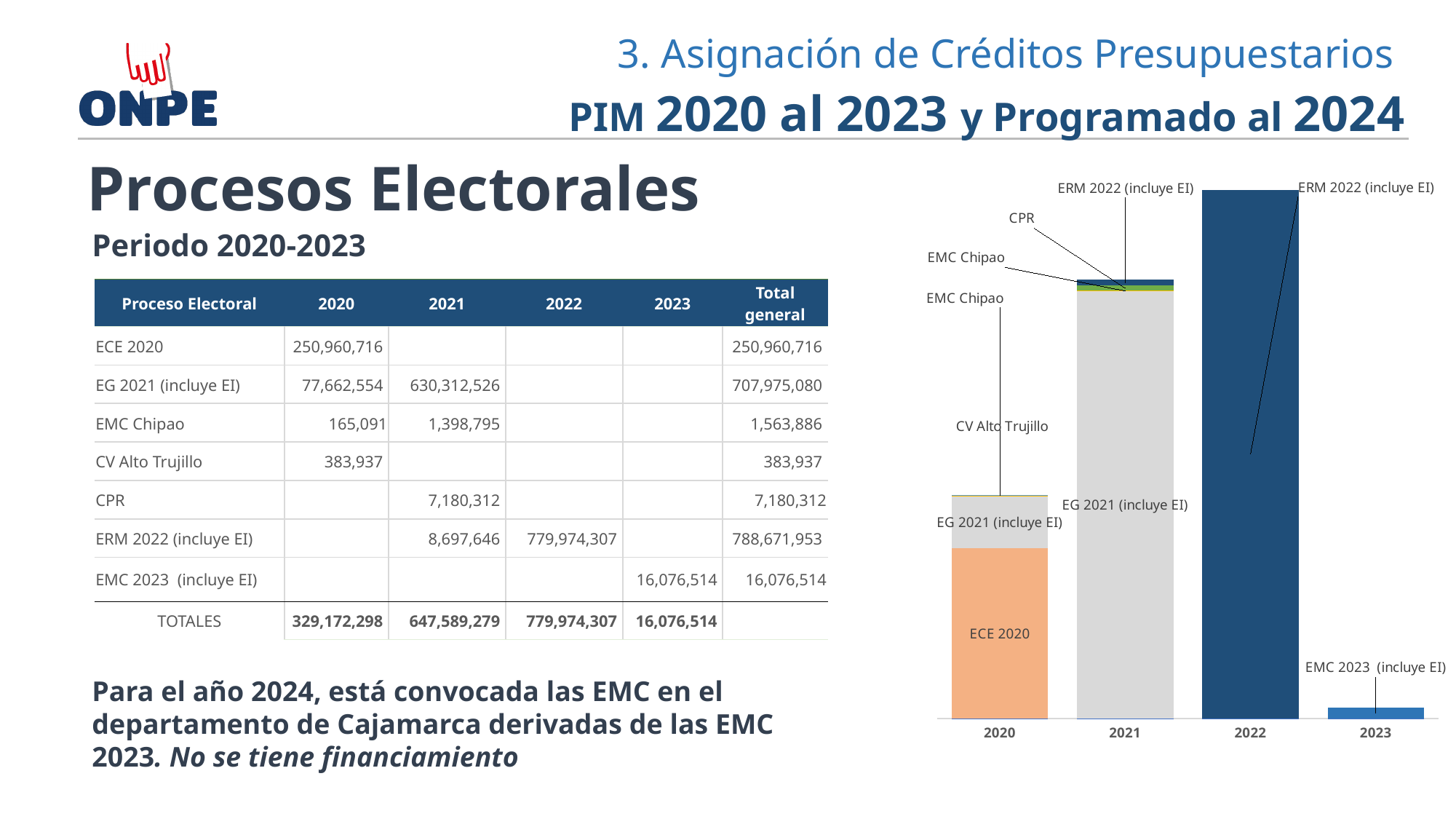
Which single process makes up the entire 2022 bar in the chart? ERM 2022 (incluye EI) What kind of chart is shown on the right of the slide? Stacked bar chart Which year has the shortest bar in the chart? 2023 Which year has the tallest bar in the chart? 2022 Which segment makes up the largest part of the 2020 bar in the chart? ECE 2020 How many years are shown on the x axis of the chart? 4 How do the bar heights change from 2020 to 2023 in the chart? They rise from 2020 to 2022, then fall sharply in 2023 According to the table, what is the value of the EMC 2023 (incluye EI) bar for 2023? 16,076,514 Which bar is taller in the chart, 2020 or 2021? 2021 How many segments are stacked in the 2020 bar of the chart? 4 What colour is the ECE 2020 segment in the chart? Orange According to the table, what is the total value of the 2022 bar? 779,974,307